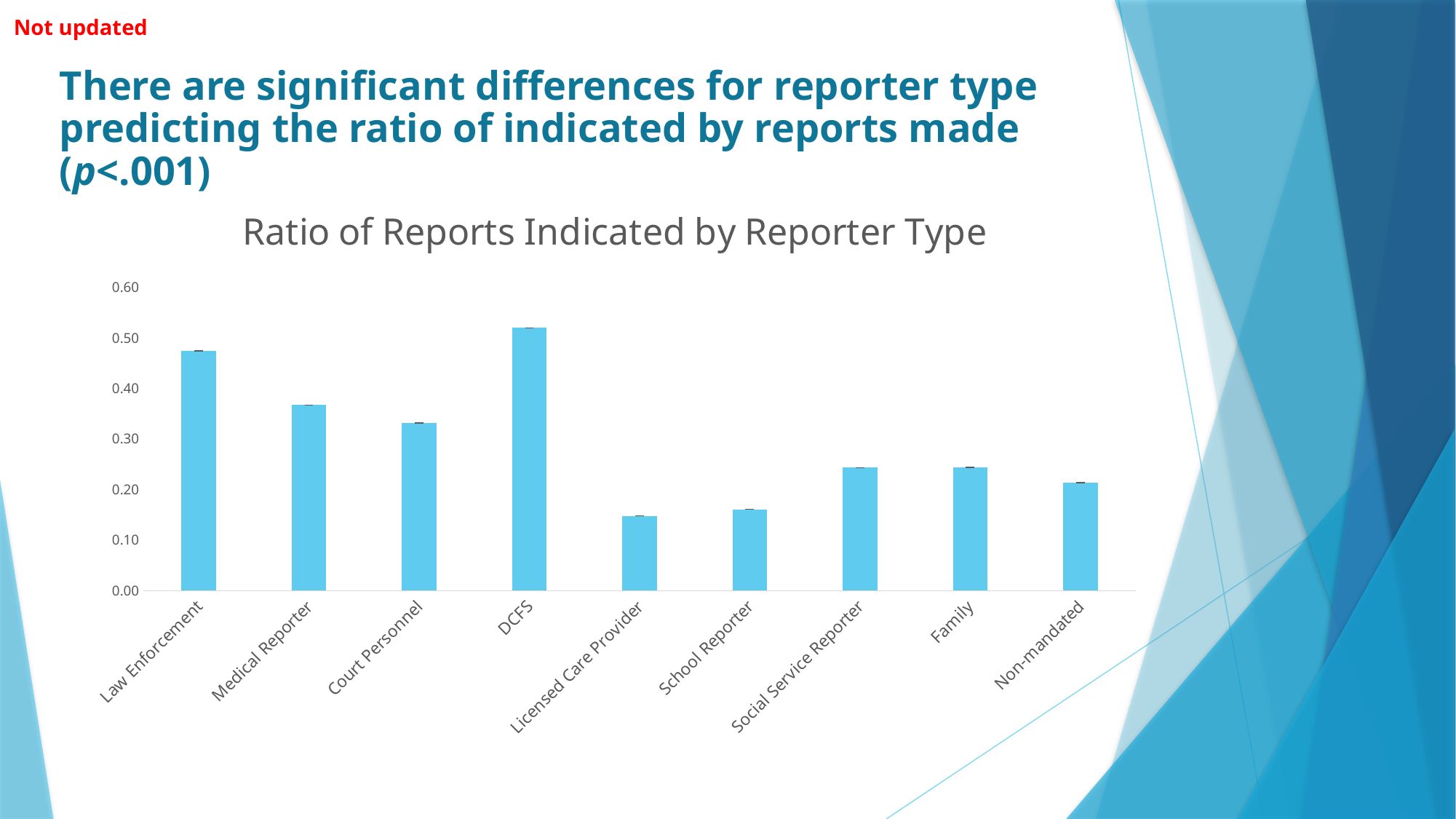
Which reporter type has the highest ratio of reports indicated? DCFS Which has a higher ratio, Law Enforcement or Medical Reporter? Law Enforcement Is the value for Family greater or less than 0.30? less Is the value for Law Enforcement greater or less than 0.50? less How many reporter types are shown on the x axis of the chart? 9 Is the value for Medical Reporter greater or less than 0.30? greater Which has a higher ratio, Court Personnel or Non-mandated? Court Personnel What is the title of the chart? Ratio of Reports Indicated by Reporter Type What type of chart is shown on the slide? Bar chart